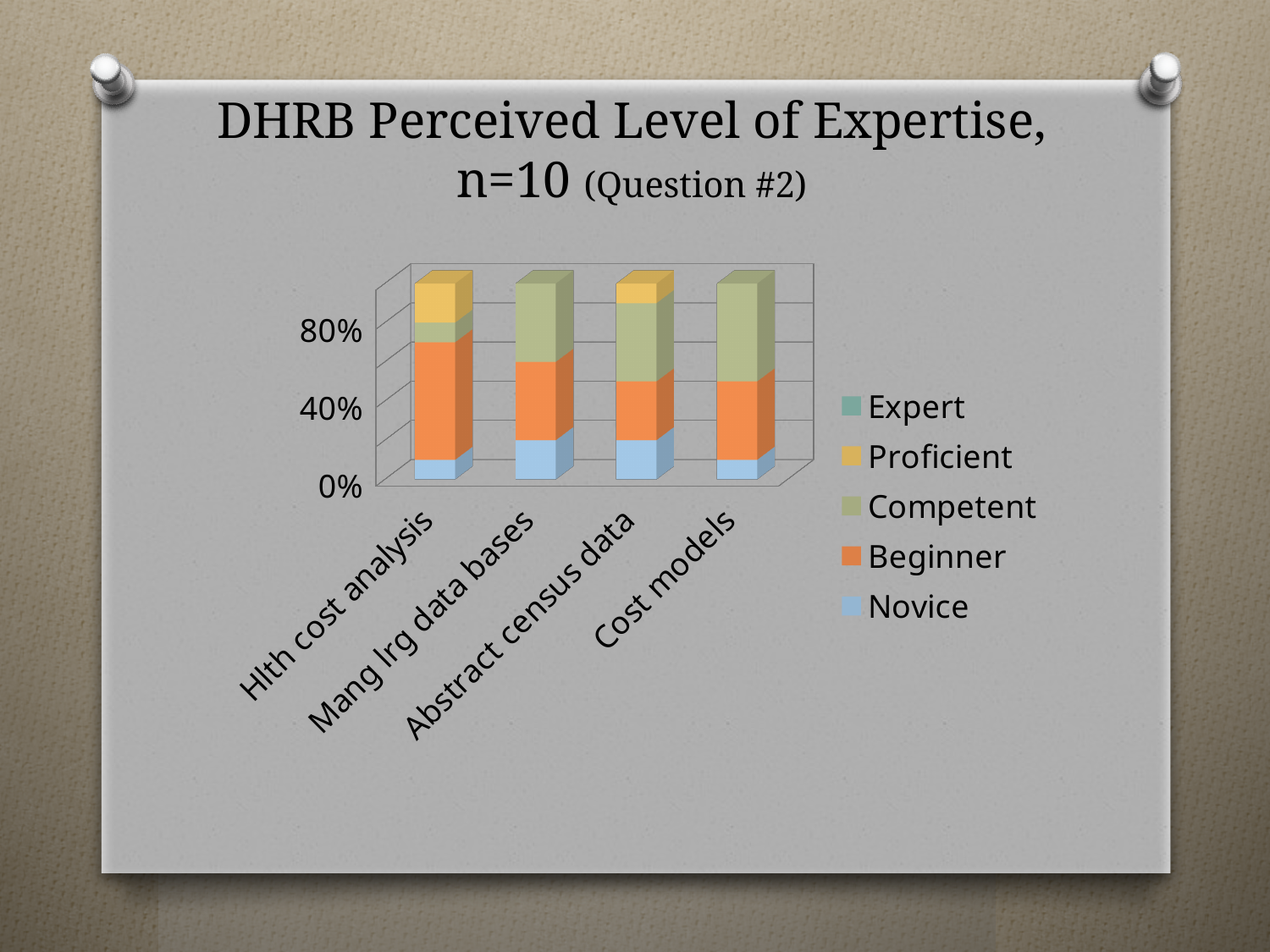
Is the Competent value for Hlth cost analysis greater or less than 40%? less What is the title of the chart on the slide? DHRB Perceived Level of Expertise, n=10 (Question #2) How many series does the chart's legend list? 5 Which category has the largest Beginner segment? Hlth cost analysis Which is larger, the Novice value for Mang lrg data bases or the Novice value for Cost models? Mang lrg data bases Which categories show a Proficient segment in their bar? Hlth cost analysis and Abstract census data Is the Beginner value for Hlth cost analysis greater or less than 40%? greater How many categories are shown on the x axis of the chart? 4 Which legend entries are listed in the chart, from top to bottom? Expert, Proficient, Competent, Beginner, Novice Is the Novice value for Cost models greater or less than 40%? less Which is larger, the Beginner value for Hlth cost analysis or the Beginner value for Abstract census data? Hlth cost analysis What kind of chart is shown on the slide? Stacked bar chart